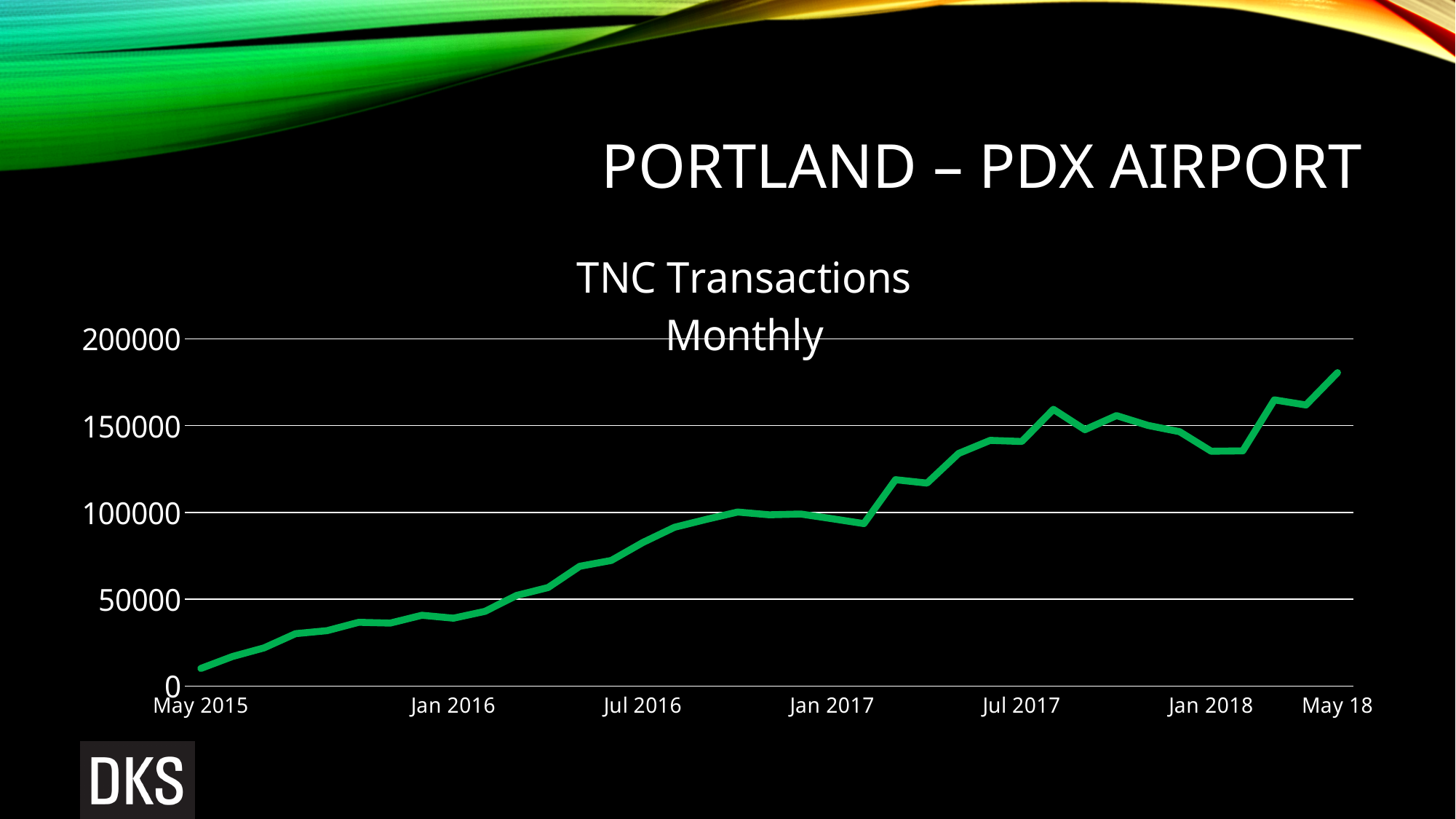
Is the value for Jan 2016 greater or less than 50000? less What is the highest value shown on the y axis? 200000 What is the title of the chart? TNC Transactions Monthly Is the value for May 18 greater or less than 150000? greater Which is larger, the value for Jul 2016 or the value for Jul 2017? Jul 2017 What kind of chart is shown on the slide? line chart Is the value for Jul 2016 greater or less than 100000? less Which labelled month on the x axis has the highest value? May 18 Which labelled month on the x axis has the lowest value? May 2015 Overall, do TNC transactions rise or fall from May 2015 to May 18? rise